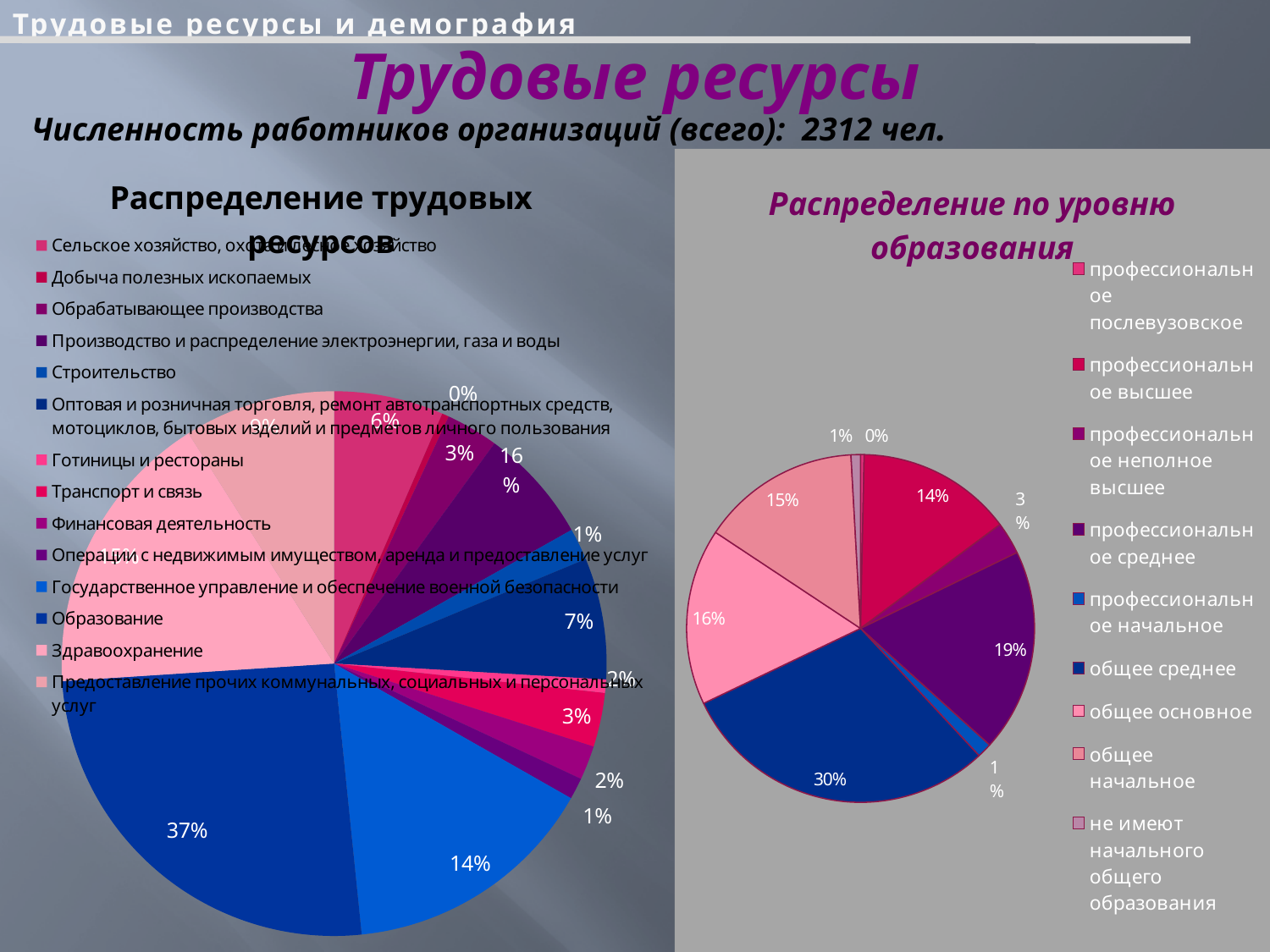
In the left pie chart (Распределение трудовых ресурсов), what share is labelled for Государственное управление и обеспечение военной безопасности? 14% In the left pie chart (Распределение трудовых ресурсов), what share is labelled for Образование? 37% How many categories does the legend of the left pie chart (Распределение трудовых ресурсов) list? 14 In the right pie chart (Распределение по уровню образования), what share is labelled for общее среднее? 30% How many categories does the legend of the right pie chart (Распределение по уровню образования) list? 9 In the right pie chart (Распределение по уровню образования), what share is labelled for профессиональное высшее? 14% In the right pie chart (Распределение по уровню образования), what is the difference between the shares for общее основное and общее начальное? 1% In the right pie chart (Распределение по уровню образования), what share is labelled for профессиональное среднее? 19% In the right pie chart (Распределение по уровню образования), which is larger: профессиональное среднее or профессиональное высшее? профессиональное среднее In the right pie chart (Распределение по уровню образования), which category has the largest share? общее среднее In the left pie chart (Распределение трудовых ресурсов), which category has the largest share? Образование What type of chart is used for Распределение по уровню образования? Pie chart